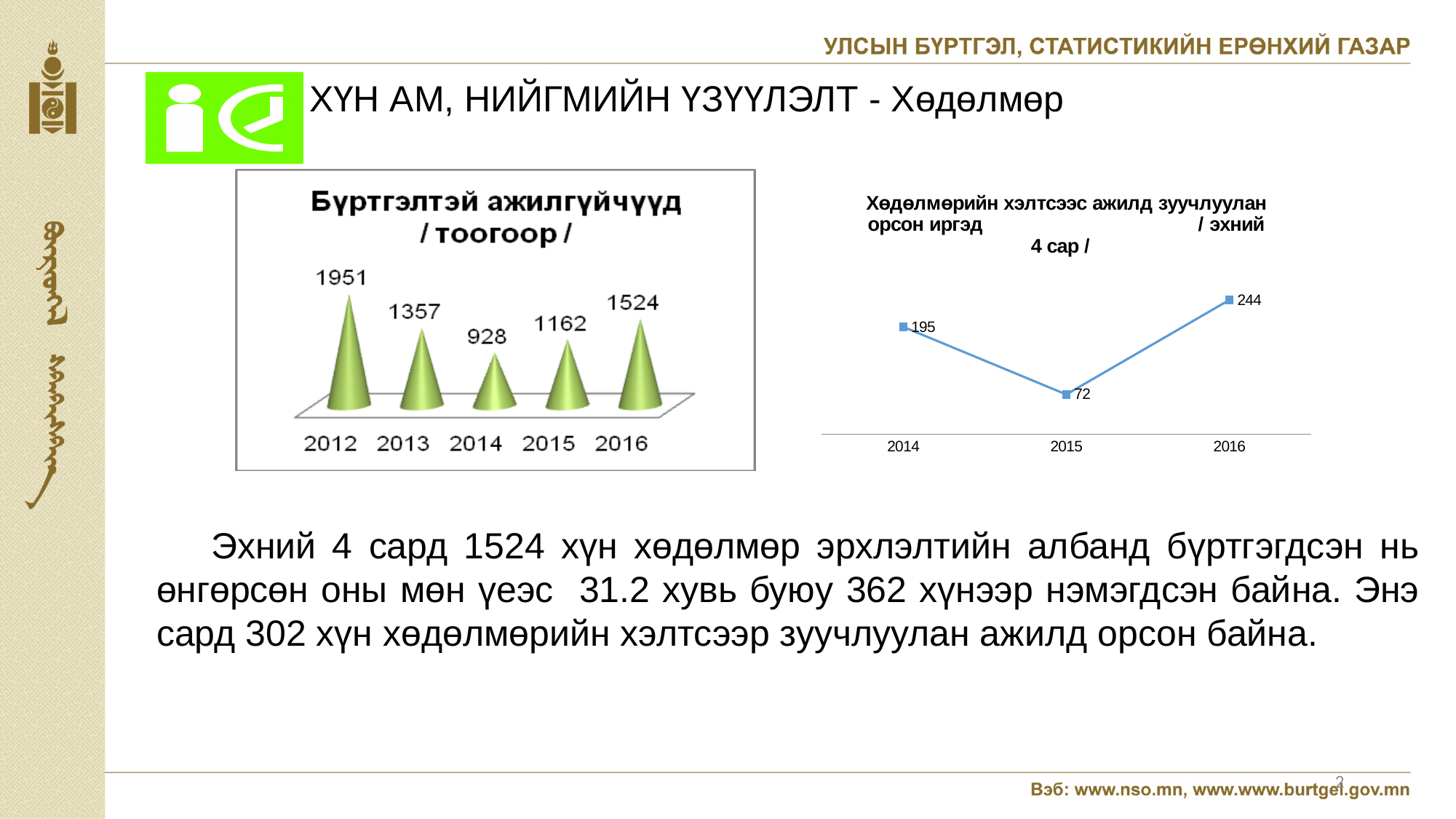
In the right chart (Хөдөлмөрийн хэлтсээс ажилд зуучлуулан орсон иргэд), what is the value for 2015? 72 In the left chart titled 'Бүртгэлтэй ажилгүйчүүд', what is the value for 2014? 928 In the left chart titled 'Бүртгэлтэй ажилгүйчүүд', what is the difference between the values for 2016 and 2015? 362 In the right chart (Хөдөлмөрийн хэлтсээс ажилд зуучлуулан орсон иргэд), does the value rise or fall from 2015 to 2016? Rise What kind of chart is the right chart (Хөдөлмөрийн хэлтсээс ажилд зуучлуулан орсон иргэд)? Line chart How many years are shown in the left chart titled 'Бүртгэлтэй ажилгүйчүүд'? 5 In the left chart titled 'Бүртгэлтэй ажилгүйчүүд', which year has the lowest value? 2014 In the left chart titled 'Бүртгэлтэй ажилгүйчүүд', which is larger, the value for 2013 or the value for 2016? 2016 In the right chart (Хөдөлмөрийн хэлтсээс ажилд зуучлуулан орсон иргэд), which year has the highest value? 2016 In the right chart (Хөдөлмөрийн хэлтсээс ажилд зуучлуулан орсон иргэд), what is the difference between the values for 2016 and 2014? 49 In the left chart titled 'Бүртгэлтэй ажилгүйчүүд', which year has the highest value? 2012 In the left chart titled 'Бүртгэлтэй ажилгүйчүүд', what is the value for 2012? 1951